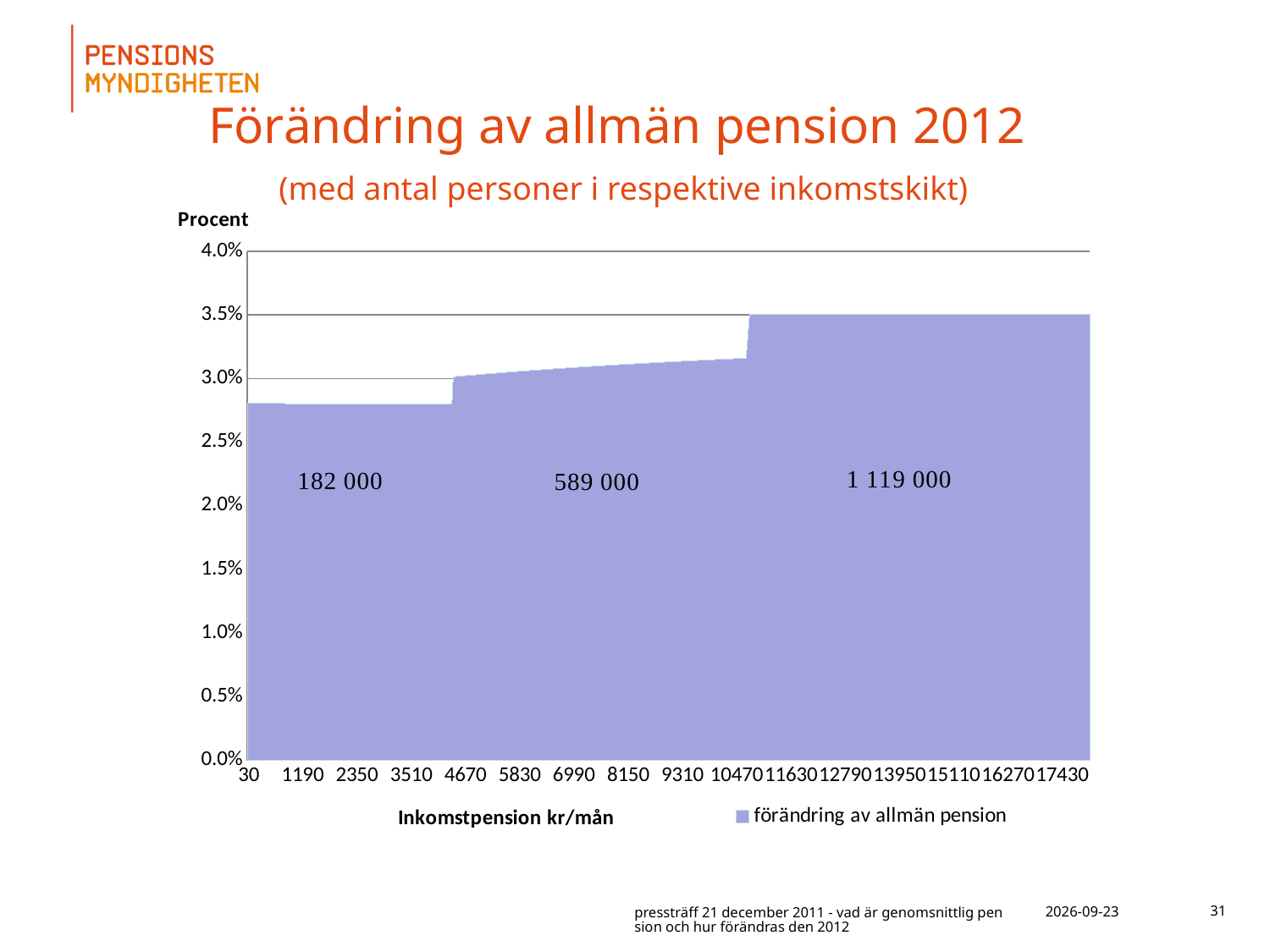
What is the label on the x axis? Inkomstpension kr/mån Which is larger, the value for 30 kr/mån or the value for 17430 kr/mån? 17430 kr/mån Is the value for 30 kr/mån greater or less than 3.0%? less Do the values rise or fall as income pension increases along the x axis? rise Is the value for 8150 kr/mån greater or less than 3.5%? less Is the value for 17430 kr/mån greater or less than 4.0%? less How many persons are shown for the highest income bracket (the rightmost segment)? 1 119 000 How many series does the legend list? 1 What kind of chart is shown on the slide? area chart What is the legend entry for the plotted series? förändring av allmän pension